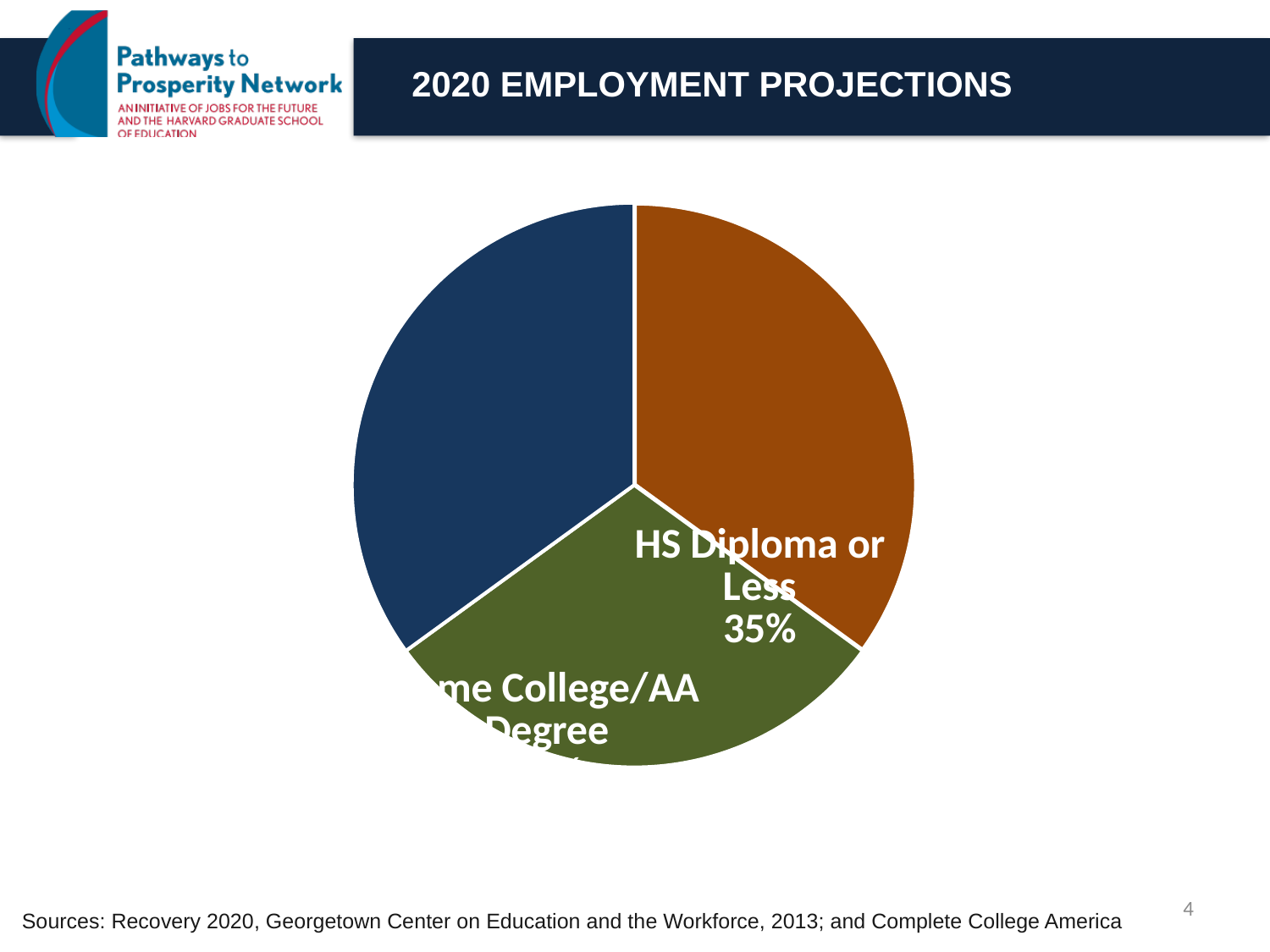
How many slices does the pie chart have? 3 What colour is the HS Diploma or Less slice? orange Which slice of the pie chart is the smallest? Some College/AA Degree What is the title of the slide containing the pie chart? 2020 EMPLOYMENT PROJECTIONS What share of the pie does the HS Diploma or Less slice represent? 35% Which is larger, the blue slice or the green Some College/AA Degree slice? the blue slice What kind of chart is shown on the slide? pie chart What percentage is shown for the HS Diploma or Less slice? 35%